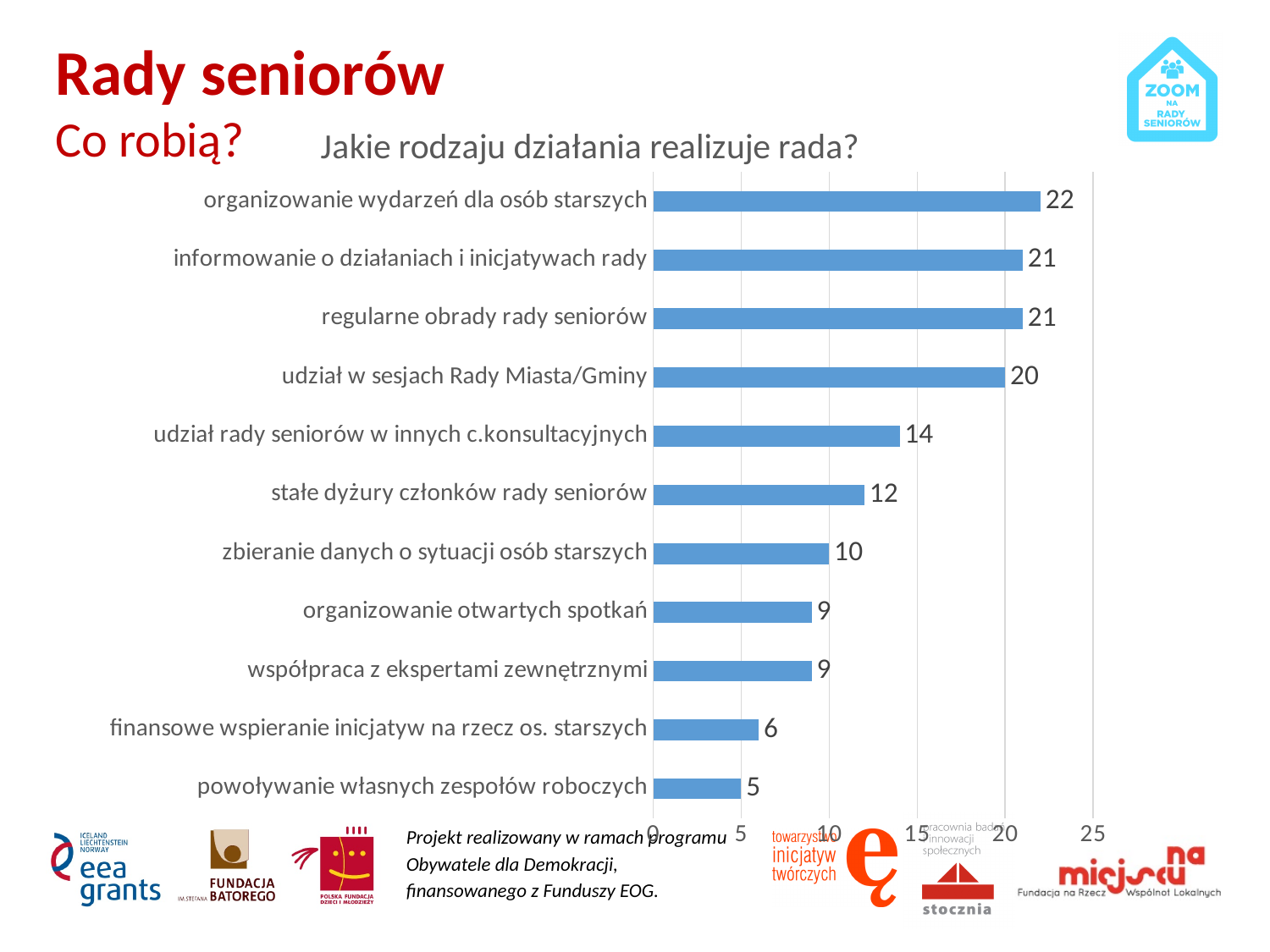
What is the value for "organizowanie wydarzeń dla osób starszych"? 22 What is the value for "współpraca z ekspertami zewnętrznymi"? 9 What is the title of the chart? Jakie rodzaju działania realizuje rada? Is the value for "regularne obrady rady seniorów" greater or less than 15? greater How many categories are shown in the chart? 11 Which is larger: the value for "zbieranie danych o sytuacji osób starszych" or the value for "organizowanie otwartych spotkań"? zbieranie danych o sytuacji osób starszych What is the value for "finansowe wspieranie inicjatyw na rzecz os. starszych"? 6 Which category has the lowest value? powoływanie własnych zespołów roboczych What is the value for "udział rady seniorów w innych c.konsultacyjnych"? 14 What is the difference between the values for "udział w sesjach Rady Miasta/Gminy" and "stałe dyżury członków rady seniorów"? 8 Which category has the highest value? organizowanie wydarzeń dla osób starszych What kind of chart is shown on the slide? bar chart